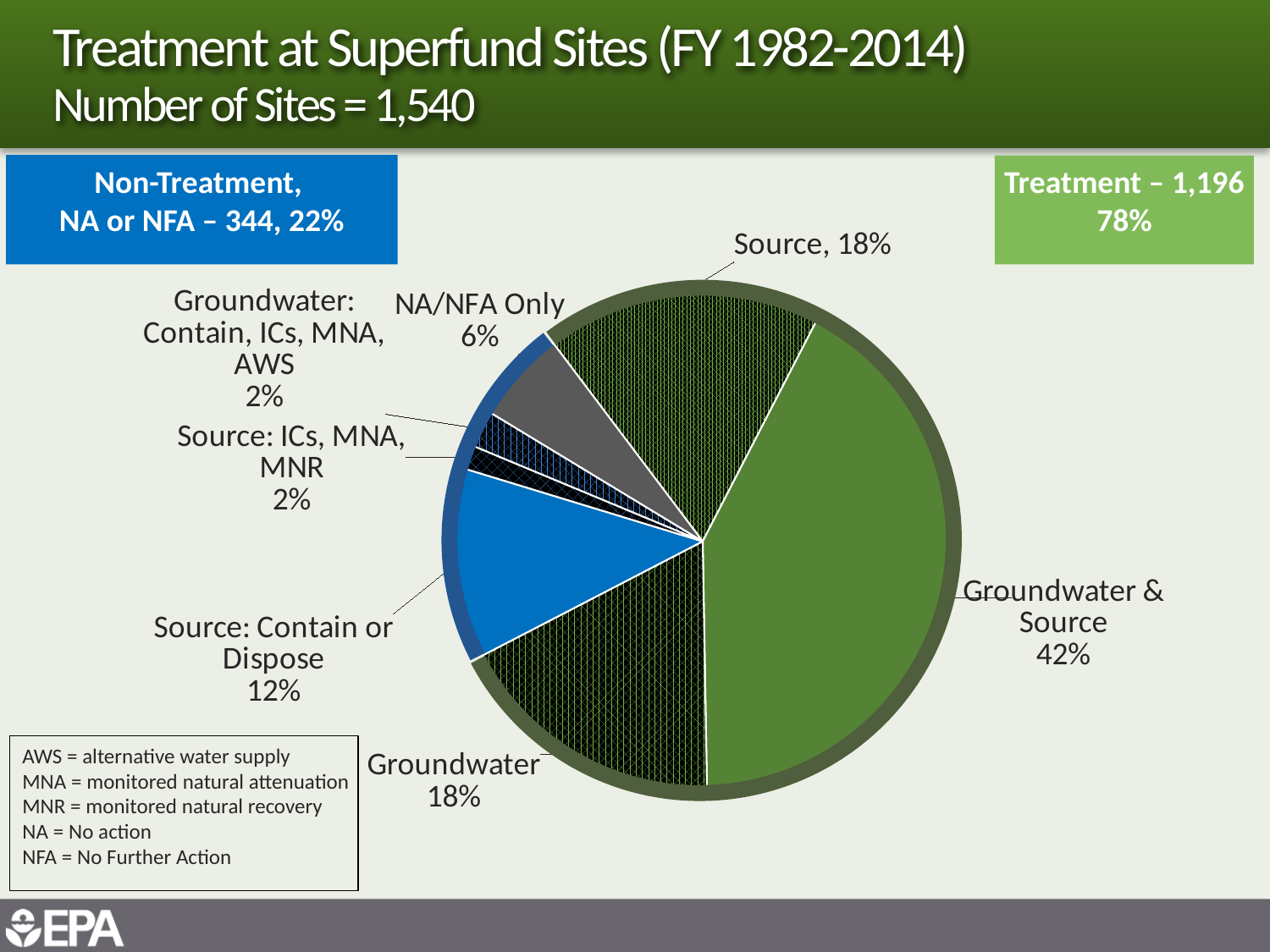
What percentage is shown for the Source: ICs, MNA, MNR slice? 2% What is the combined percentage of the Source slice and the Groundwater slice? 36% Which is larger, the Source: Contain or Dispose slice or the NA/NFA Only slice? Source: Contain or Dispose What share of the pie does the Groundwater & Source slice represent? 42% What is the title of the slide containing the pie chart? Treatment at Superfund Sites (FY 1982-2014) What percentage is shown for the NA/NFA Only slice? 6% What percentage is shown for the Source slice? 18% Which slice of the pie is the largest? Groundwater & Source How many slices does the pie chart have? 7 What kind of chart is shown on the slide? pie chart What percentage is shown for the Source: Contain or Dispose slice? 12% What is the difference in percentage points between the Groundwater & Source slice and the Groundwater slice? 24